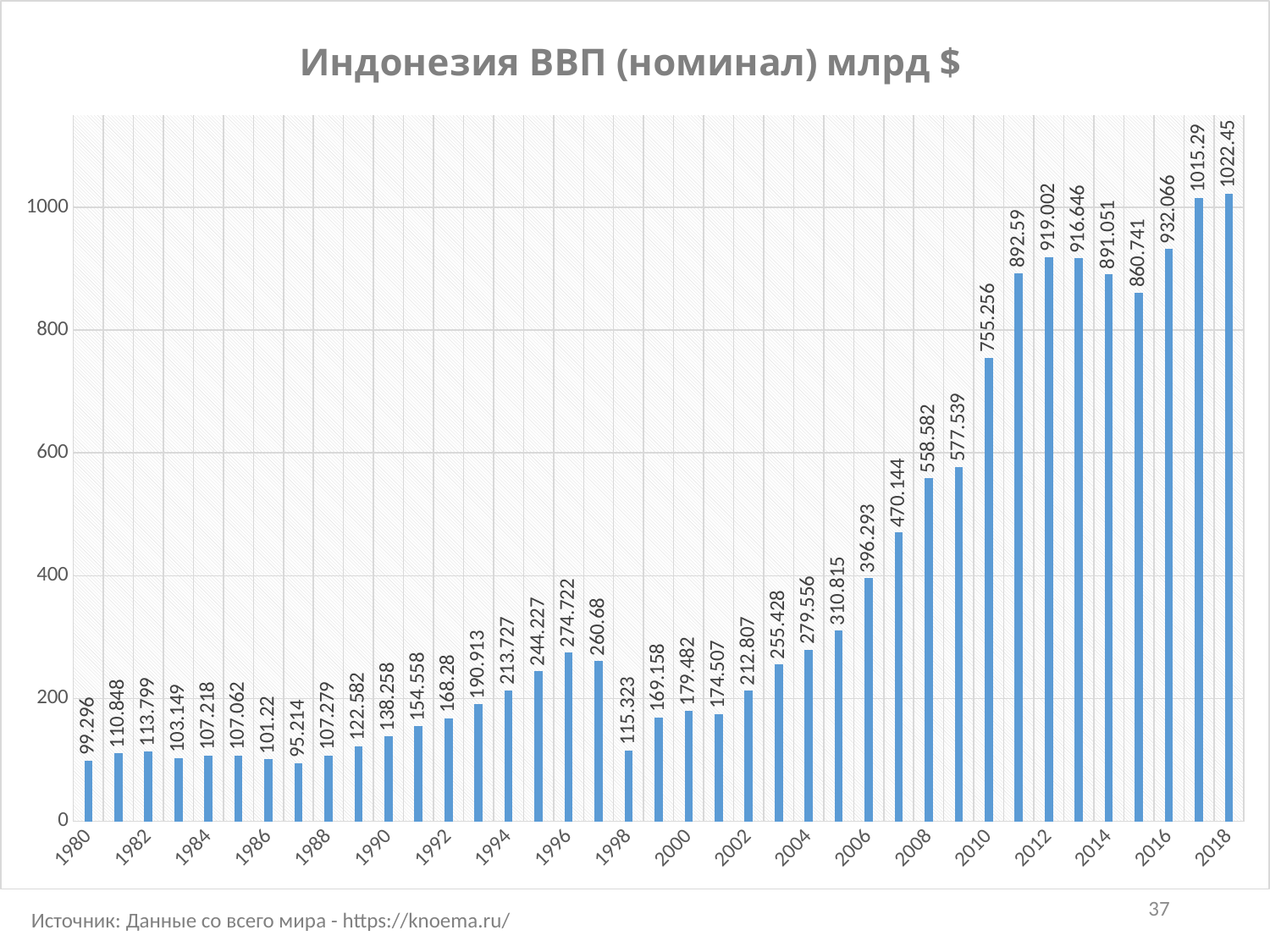
What kind of chart is shown on the slide? bar chart What is the lowest value shown on the chart? 95.214 What is the value for 1980? 99.296 Is the value for 2006 greater or less than 400? less What is the value for 2018? 1022.45 What is the value for 1998? 115.323 What is the value for 2010? 755.256 What is the difference between the values for 2018 and 2016? 90.384 Which year has the highest value? 2018 Which is larger, the value for 2012 or the value for 2014? 2012 What is the title of the chart? Индонезия ВВП (номинал) млрд $ Overall, do the values rise or fall from 1980 to 2018? rise